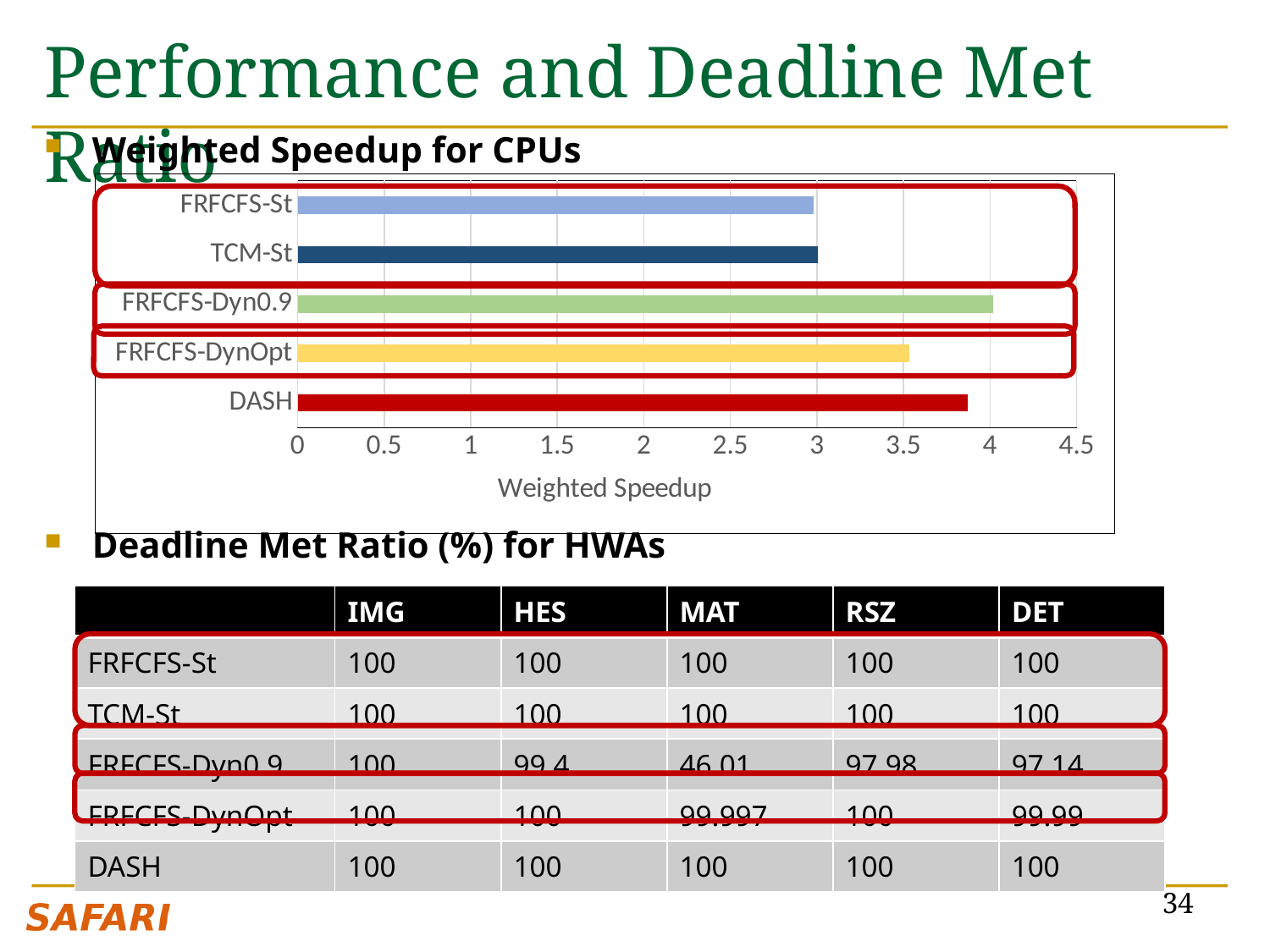
What is the x-axis title of the Weighted Speedup for CPUs chart? Weighted Speedup What colour is the DASH bar in the Weighted Speedup for CPUs chart? red In the Weighted Speedup for CPUs chart, is the value for FRFCFS-St greater or less than 3.5? less How many categories (scheduling policies) are plotted in the Weighted Speedup for CPUs chart? 5 In the Weighted Speedup for CPUs chart, which has the larger weighted speedup, DASH or FRFCFS-DynOpt? DASH In the Weighted Speedup for CPUs chart, which has the larger weighted speedup, FRFCFS-Dyn0.9 or DASH? FRFCFS-Dyn0.9 In the Weighted Speedup for CPUs chart, is the value for FRFCFS-Dyn0.9 greater or less than 3.5? greater In the Weighted Speedup for CPUs chart, is the value for TCM-St greater or less than 2.5? greater In the Weighted Speedup for CPUs chart, which category has the highest weighted speedup? FRFCFS-Dyn0.9 What kind of chart is the Weighted Speedup for CPUs chart? bar chart